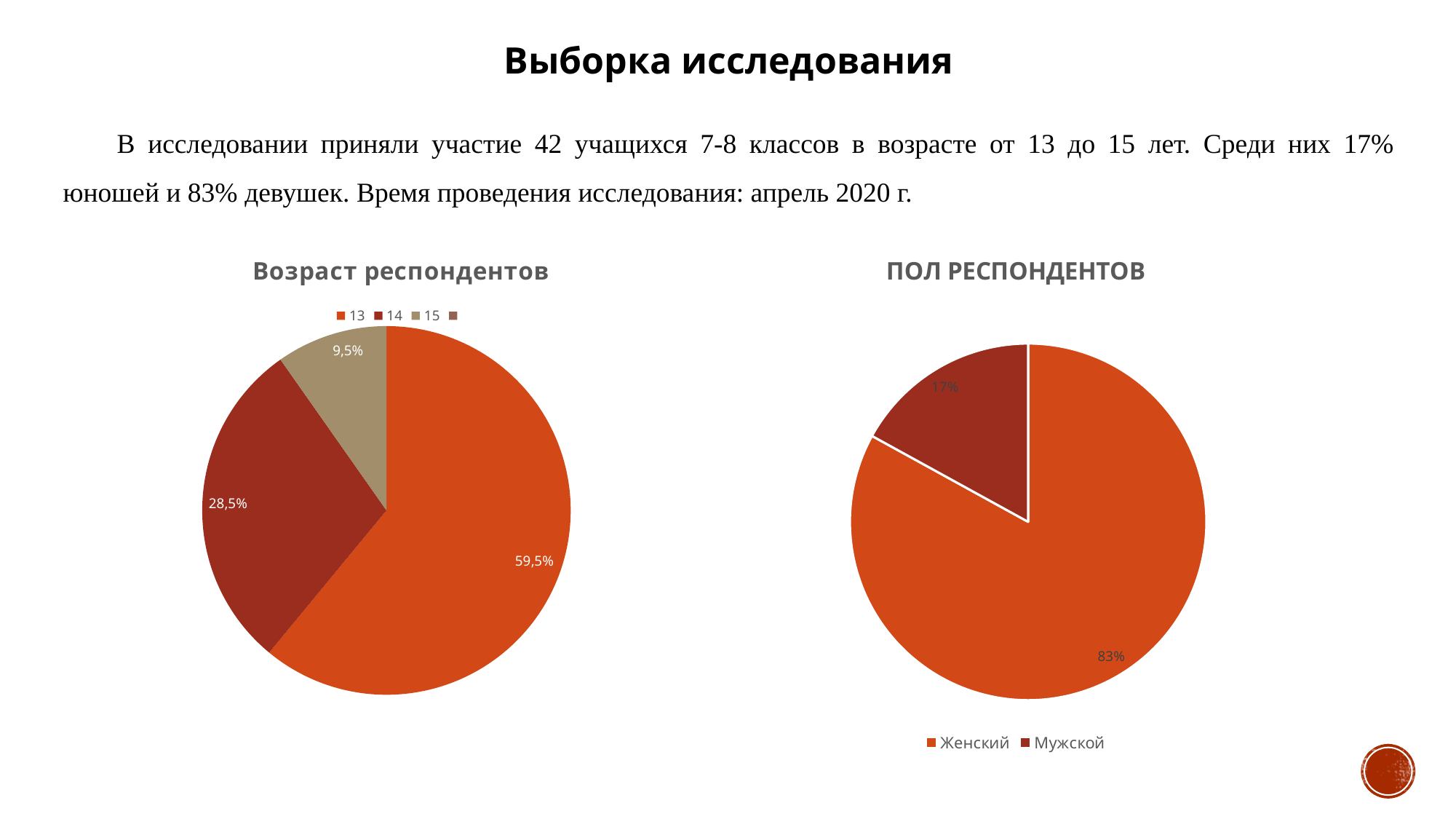
In the 'ПОЛ РЕСПОНДЕНТОВ' chart, what share of respondents are Женский? 83% In the 'Возраст респондентов' chart, what is the difference between the shares for age 13 and age 14? 31% In the 'Возраст респондентов' chart, which slice is larger: age 14 or age 15? 14 In the 'Возраст респондентов' chart, which age group has the smallest slice? 15 What type of chart is the 'ПОЛ РЕСПОНДЕНТОВ' chart? Pie chart In the 'ПОЛ РЕСПОНДЕНТОВ' chart, what share of respondents are Мужской? 17% In the 'Возраст респондентов' chart, which age group has the largest slice? 13 How many entries does the legend of the 'ПОЛ РЕСПОНДЕНТОВ' chart list? 2 In the 'Возраст респондентов' chart, what share of respondents are aged 13? 59,5% In the 'Возраст респондентов' chart, what share of respondents are aged 15? 9,5% In the 'ПОЛ РЕСПОНДЕНТОВ' chart, what is the difference between the Женский and Мужской shares? 66% In the 'Возраст респондентов' chart, what share of respondents are aged 14? 28,5%